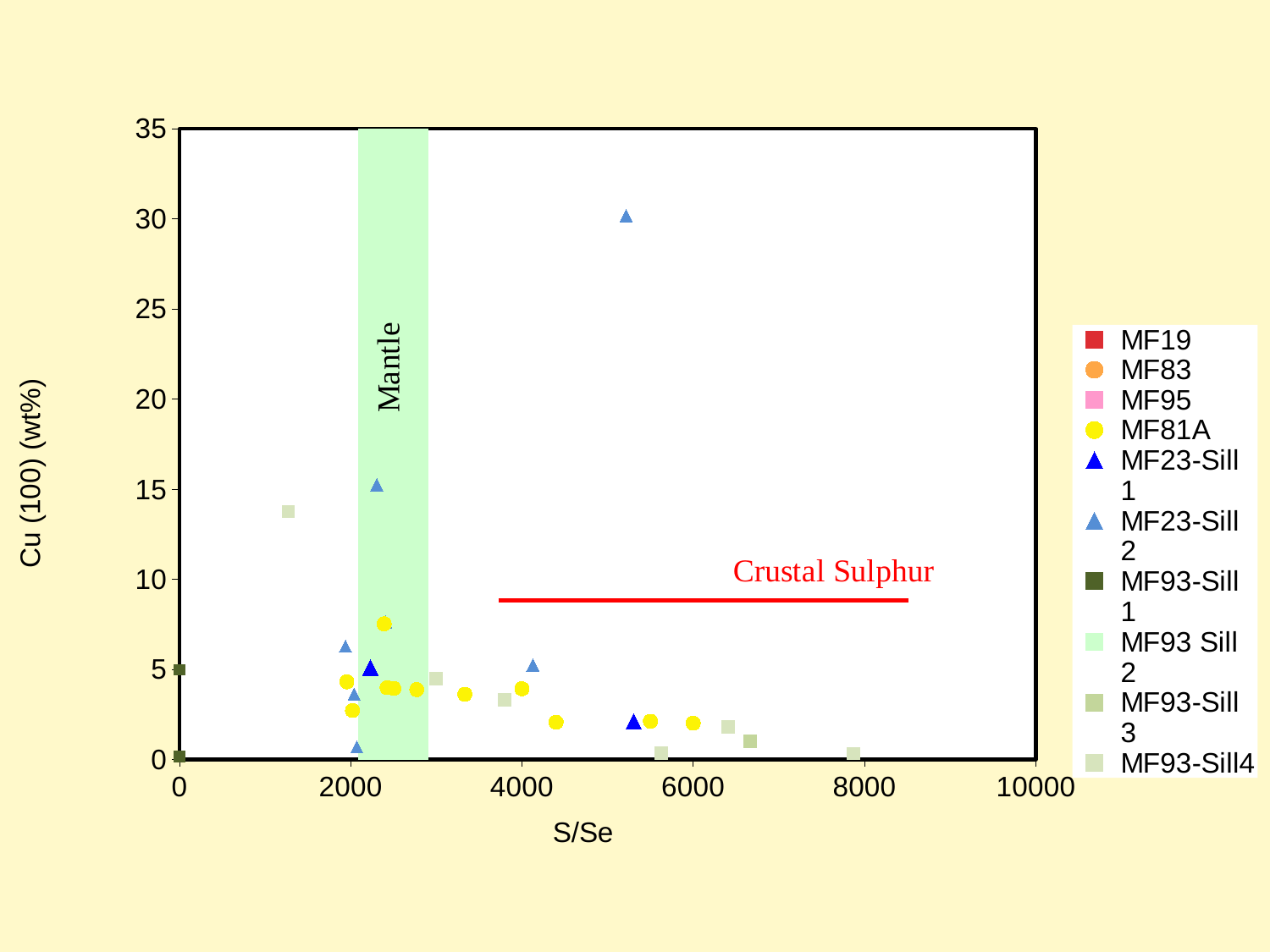
Is the MF23-Sill 2 point inside the Mantle band greater or less than 10 on the y axis? greater Is the MF93-Sill4 point plotted near S/Se = 1250 greater or less than 10 on the y axis? greater Are all the MF81A points plotted below 10 on the y axis? yes What is the label of the x axis? S/Se What is the highest tick value shown on the y axis? 35 Which series has the highest plotted point on the chart? MF23-Sill 2 What kind of chart is shown on the slide? scatter chart What is the highest tick value shown on the x axis? 10000 How many series does the legend list? 10